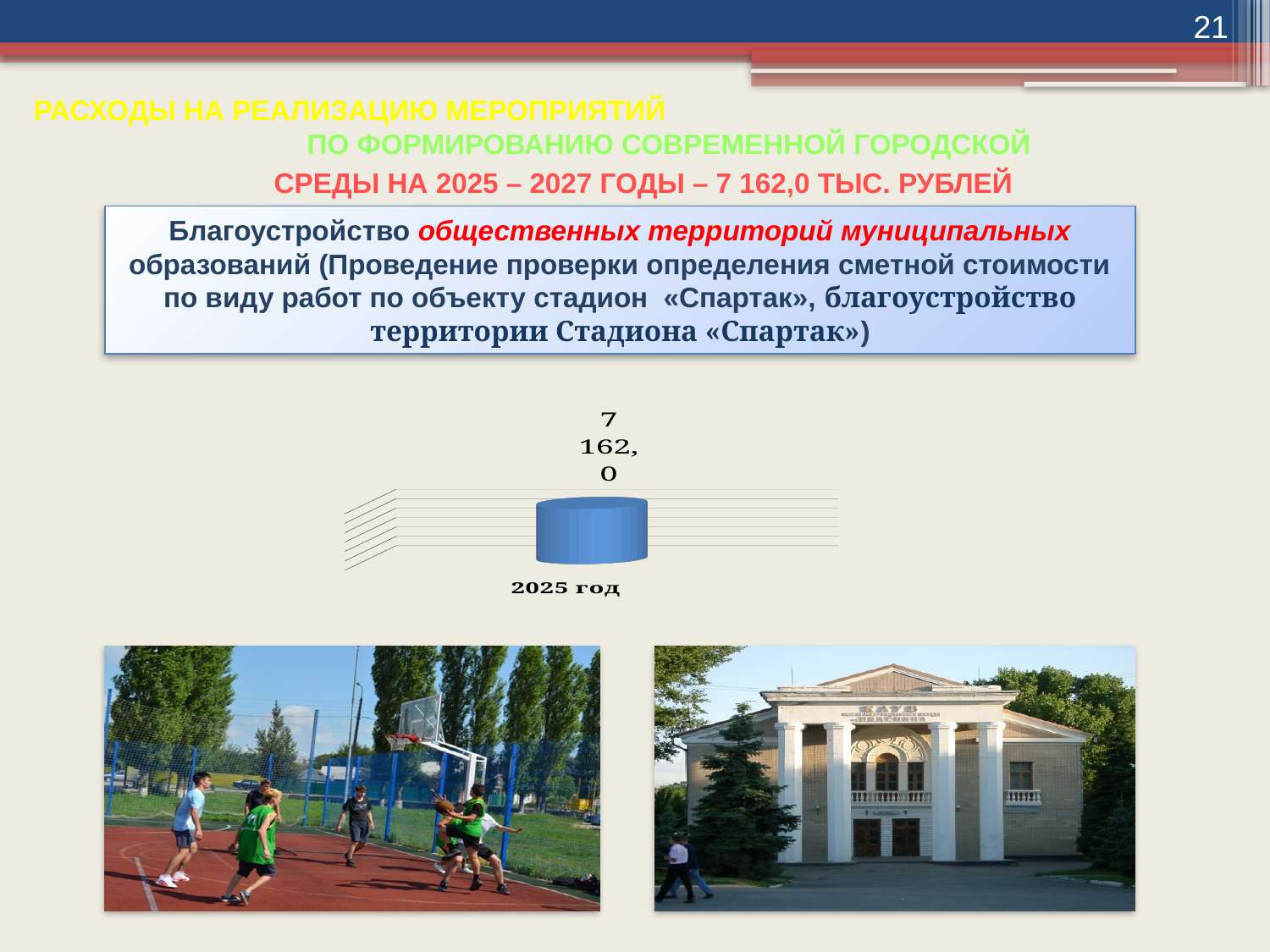
What kind of chart is shown on the slide? bar chart How many categories are plotted on the chart? 1 What value is shown for 2025 год on the chart? 7 162,0 What colour is the bar on the chart? blue What is the label of the single category on the chart's x axis? 2025 год